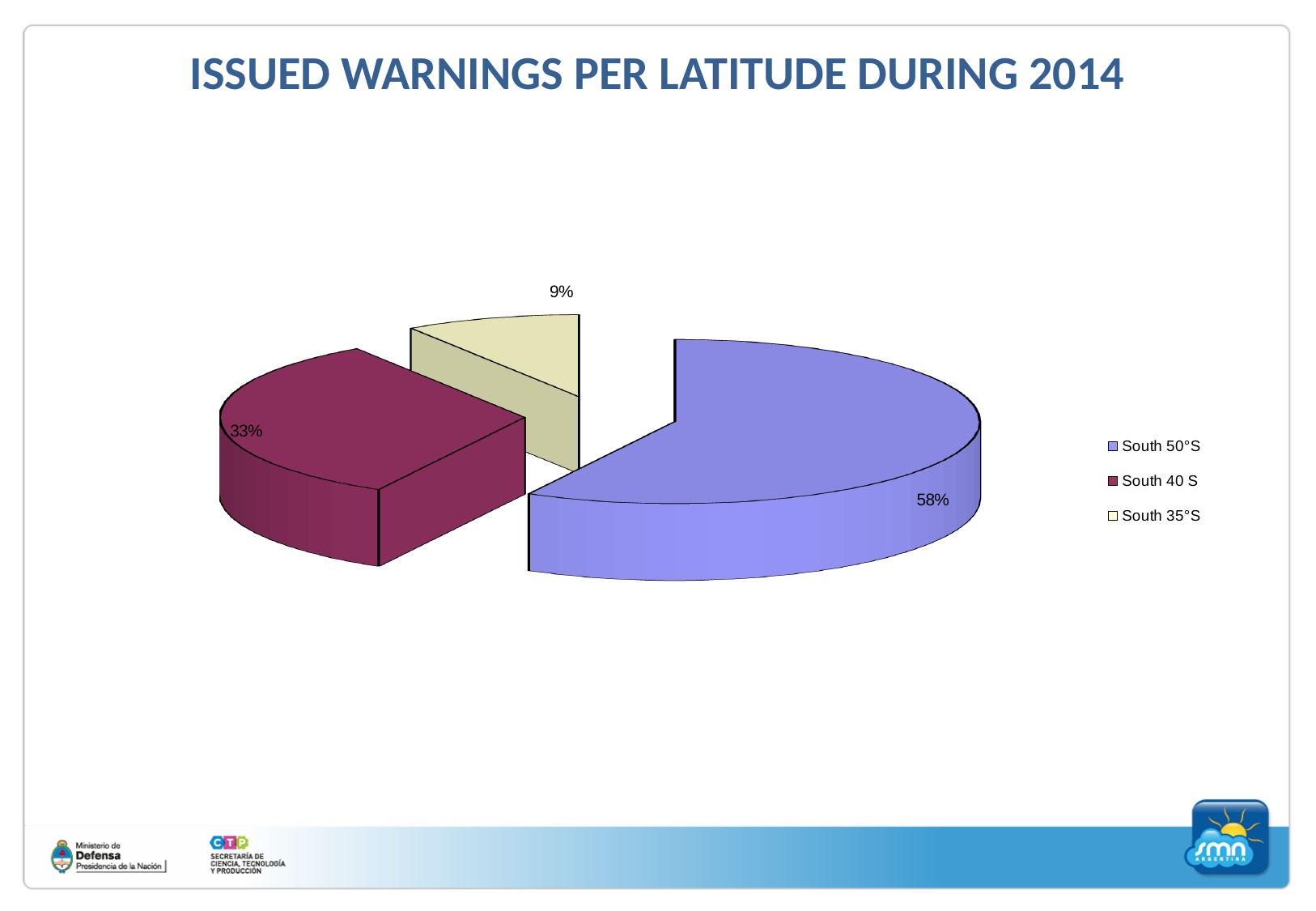
Which latitude has the largest share of issued warnings? South 50°S What kind of chart is shown on the slide? Pie chart Which latitude has the smallest share of issued warnings? South 35°S What is the difference in percentage points between the South 50°S and South 40 S shares? 25 How many slices does the pie chart have? 3 What is the difference in percentage points between the South 40 S and South 35°S shares? 24 What share of issued warnings does the South 40 S slice represent? 33% What share of issued warnings does the South 50°S slice represent? 58% Which has a larger share of issued warnings, South 40 S or South 35°S? South 40 S How many entries does the legend list? 3 What is the title of the chart? ISSUED WARNINGS PER LATITUDE DURING 2014 What share of issued warnings does the South 35°S slice represent? 9%